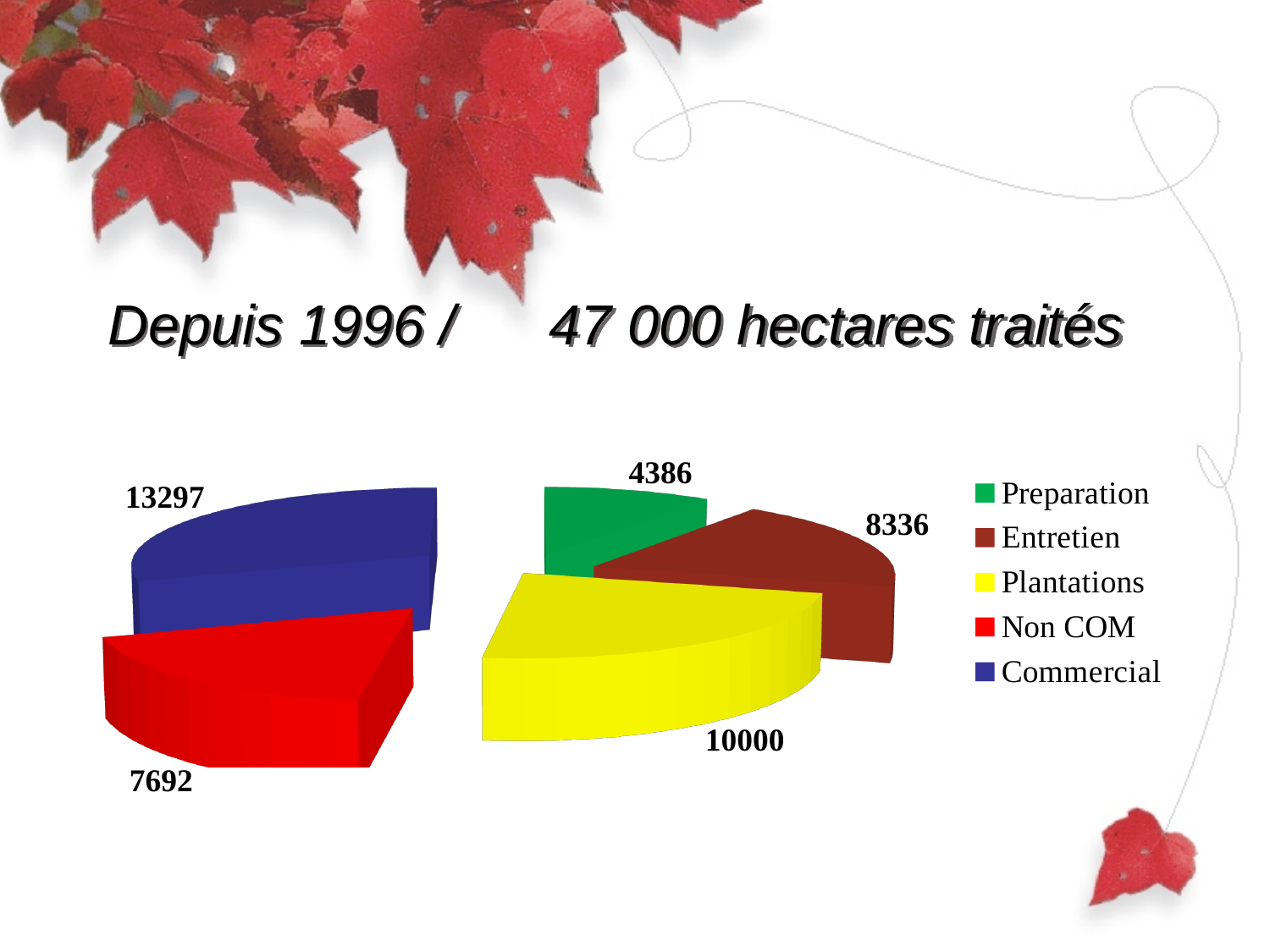
What kind of chart is shown on the slide? Pie chart Which is larger, the Entretien value or the Non COM value? Entretien What value is shown for the Plantations slice? 10000 Which category has the smallest slice of the pie? Preparation What value is shown for the Commercial slice? 13297 What value is shown for the Preparation slice? 4386 Which category has the largest slice of the pie? Commercial What colour is the Plantations slice? Yellow How many slices does the pie chart have? 5 What value is shown for the Non COM slice? 7692 What is the difference between the Commercial value and the Plantations value? 3297 What value is shown for the Entretien slice? 8336